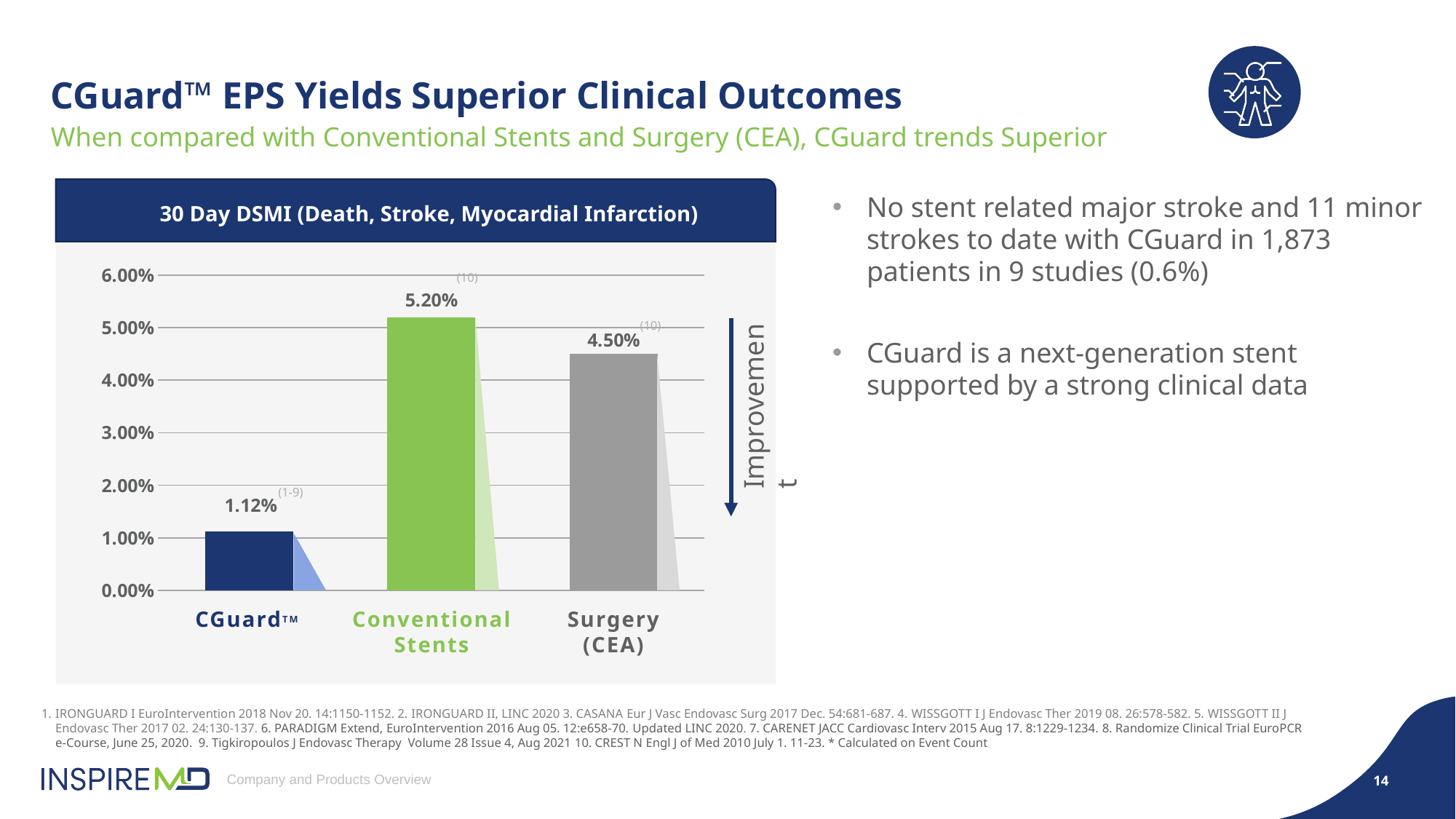
What is the 30 Day DSMI value for Surgery (CEA)? 4.50% What kind of chart is shown on the slide? Bar chart What is the title of the chart? 30 Day DSMI (Death, Stroke, Myocardial Infarction) Which category has the highest 30 Day DSMI rate? Conventional Stents What is the 30 Day DSMI value for CGuard? 1.12% What is the difference between the 30 Day DSMI rates for Conventional Stents and CGuard? 4.08% What is the difference between the 30 Day DSMI rates for Conventional Stents and Surgery (CEA)? 0.70% Which category has the lowest 30 Day DSMI rate? CGuard Which has a higher 30 Day DSMI rate, Surgery (CEA) or CGuard? Surgery (CEA) How many categories are shown in the chart? 3 What is the 30 Day DSMI value for Conventional Stents? 5.20% Is the 30 Day DSMI value for Surgery (CEA) greater or less than 4.00%? greater